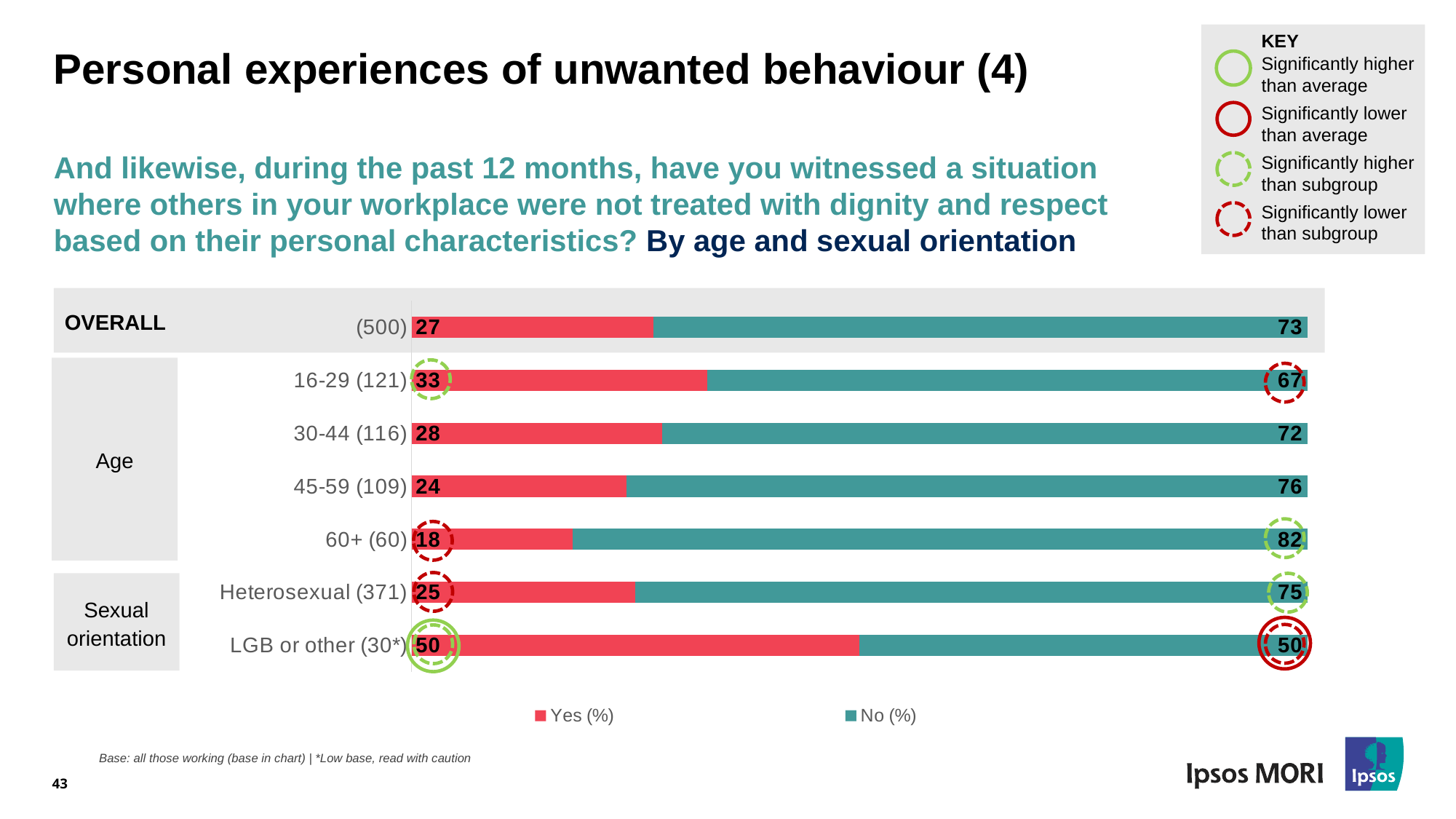
How many categories (bars) are shown in the chart? 7 Which category has the lowest Yes (%) value? 60+ (60) What is the Yes (%) value for the OVERALL (500) category? 27 What kind of chart is shown on the slide? Stacked bar chart How many series does the legend list? 2 Which colour represents the No (%) series in the chart? Teal Which category has the highest Yes (%) value? LGB or other (30*) What is the No (%) value for the 45-59 (109) age group? 76 What is the Yes (%) value for the LGB or other (30*) category? 50 What is the difference between the No (%) values for 60+ (60) and 16-29 (121)? 15 Which is larger, the Yes (%) value for 16-29 (121) or for 30-44 (116)? 16-29 (121) What is the total of the Yes (%) and No (%) values for the Heterosexual (371) bar? 100